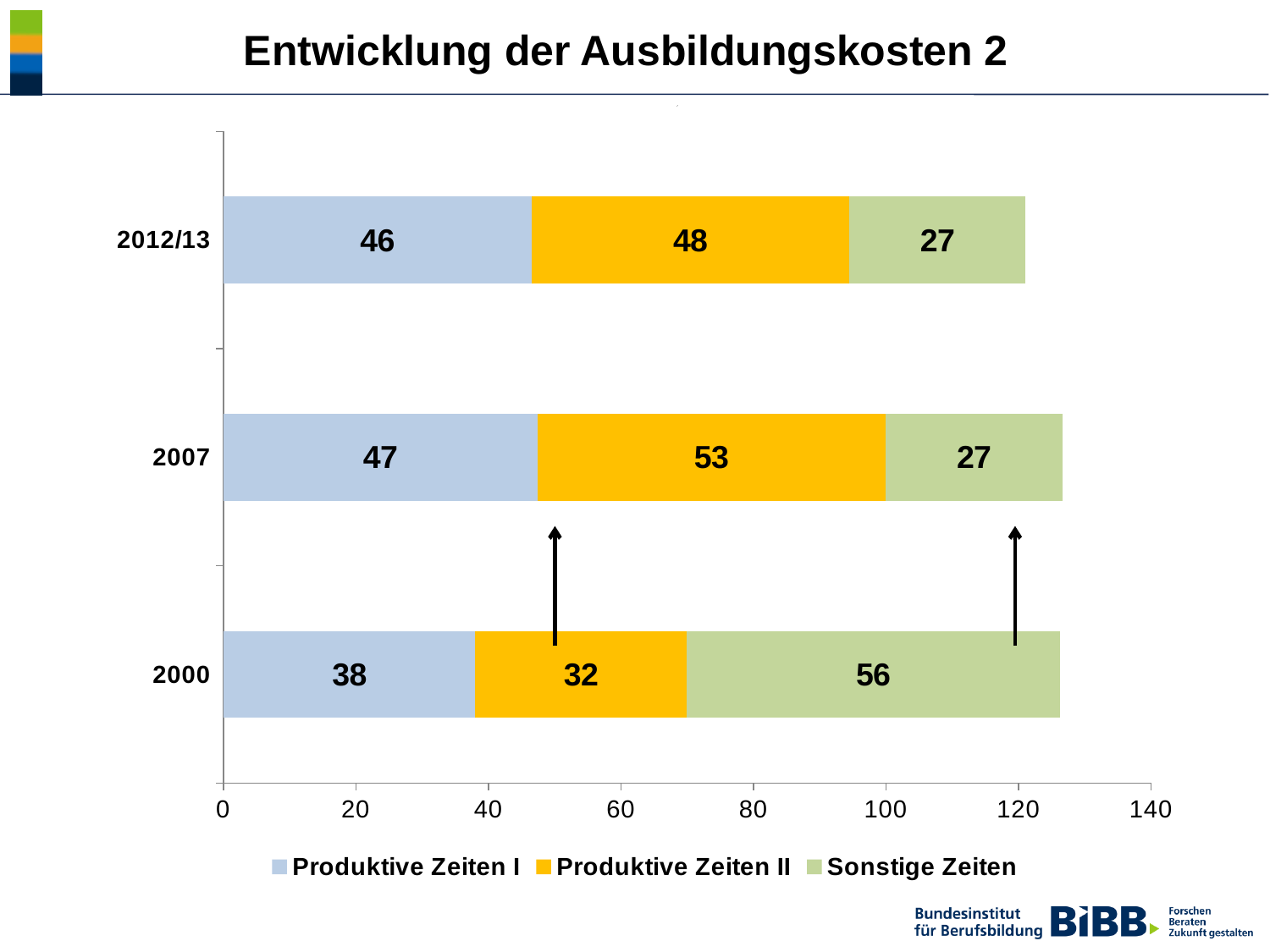
What is the value of Produktive Zeiten II for 2007? 53 What is the value of Sonstige Zeiten for 2000? 56 How many years are shown on the chart? 3 What kind of chart is shown on the slide? Stacked bar chart What is the total of the stacked bar for 2007? 127 Which year has the highest value for Sonstige Zeiten? 2000 Which year has the lowest value for Produktive Zeiten II? 2000 How many series does the legend list? 3 What is the value of Produktive Zeiten I for 2012/13? 46 Is Produktive Zeiten I larger in 2007 or in 2000? 2007 What is the total of the stacked bar for 2012/13? 121 What is the difference between Produktive Zeiten II in 2007 and in 2000? 21